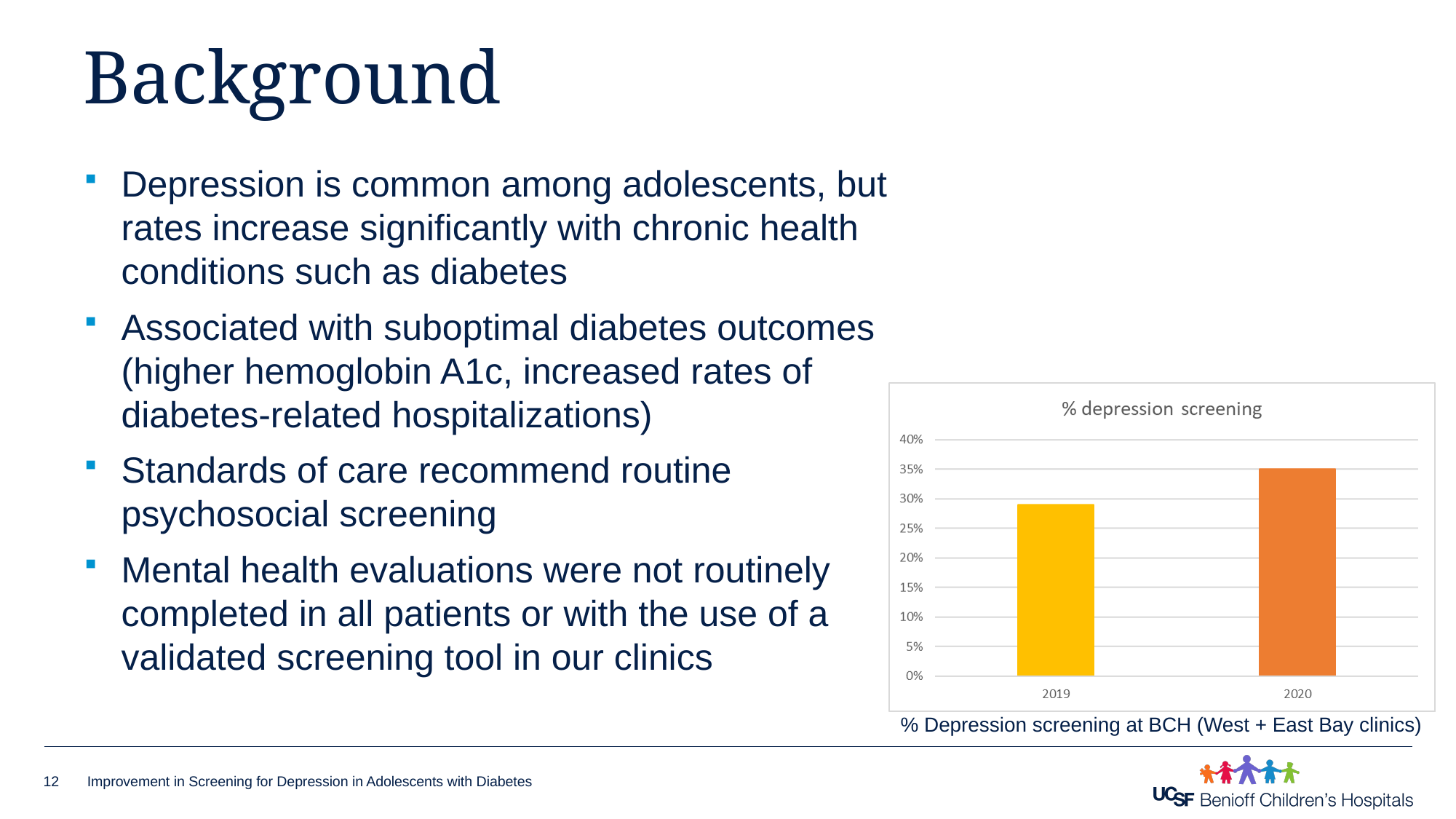
Which year has the lower % depression screening? 2019 Which is larger, the value for 2019 or the value for 2020? 2020 How many bars does the chart show? 2 Does the % depression screening rise or fall from 2019 to 2020? rise What is the highest value shown on the chart's vertical axis? 40% What kind of chart is shown on the slide? bar chart Is the value for 2020 greater or less than 30%? greater What is the % depression screening value for 2020? 35% Is the value for 2019 greater or less than 25%? greater Which year has the higher % depression screening? 2020 What is the title of the chart? % depression screening Is the value for 2019 greater or less than 30%? less